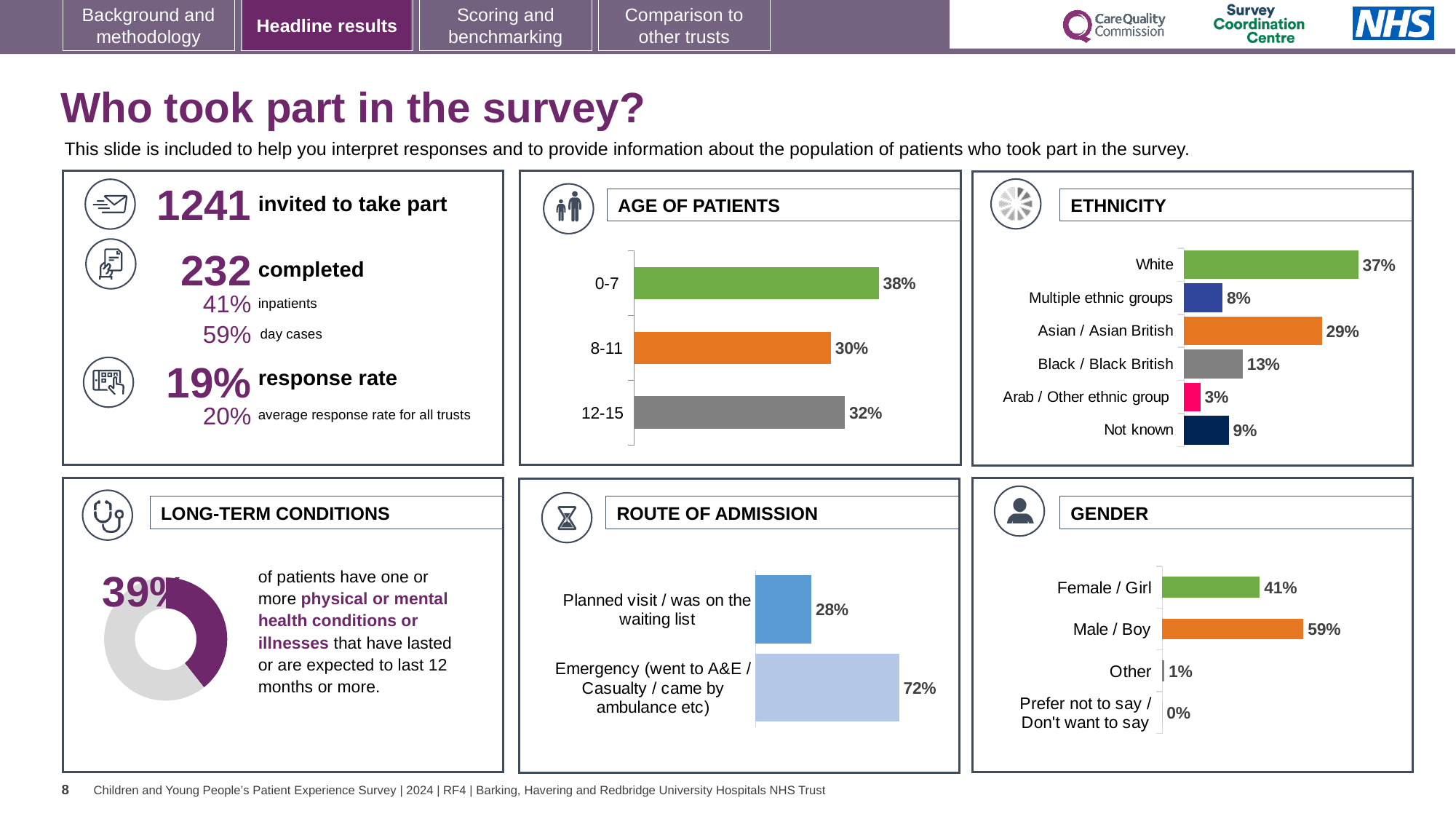
In the ETHNICITY chart, how many ethnicity categories are shown? 6 What kind of chart is used in the GENDER panel? Bar chart In the AGE OF PATIENTS chart, what percentage of patients were aged 0-7? 38% In the GENDER chart, what percentage of patients were Male / Boy? 59% In the ROUTE OF ADMISSION chart, what is the difference between the Emergency and Planned visit percentages? 44% In the ETHNICITY chart, which ethnic group has the lowest percentage? Arab / Other ethnic group In the AGE OF PATIENTS chart, what is the difference between the 0-7 and 12-15 percentages? 6% In the ETHNICITY chart, which ethnic group has the highest percentage? White In the ROUTE OF ADMISSION chart, what percentage of patients came through Emergency (went to A&E / Casualty / came by ambulance etc)? 72% In the ETHNICITY chart, which is larger: Black / Black British or Not known? Black / Black British In the ETHNICITY chart, what percentage of patients were Asian / Asian British? 29% In the AGE OF PATIENTS chart, which age group has the lowest percentage? 8-11